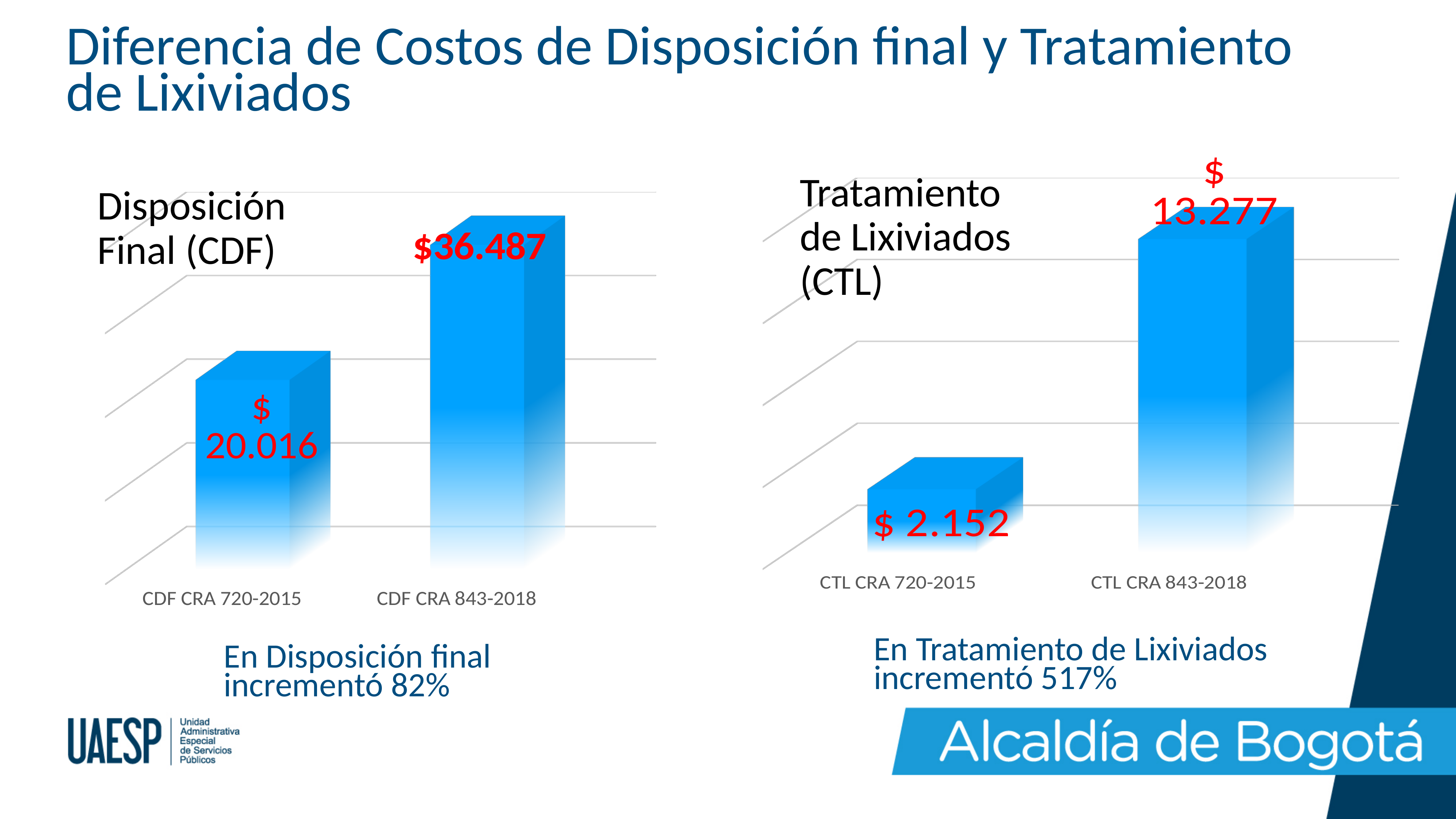
In the Disposición Final (CDF) chart, what is the value for CDF CRA 843-2018? $36.487 In the Tratamiento de Lixiviados (CTL) chart, which category has the lowest value? CTL CRA 720-2015 In the Disposición Final (CDF) chart, what is the difference between CDF CRA 843-2018 and CDF CRA 720-2015? $ 16.471 In the Tratamiento de Lixiviados (CTL) chart, which is larger: CTL CRA 720-2015 or CTL CRA 843-2018? CTL CRA 843-2018 In the Tratamiento de Lixiviados (CTL) chart, what is the difference between CTL CRA 843-2018 and CTL CRA 720-2015? $ 11.125 In the Tratamiento de Lixiviados (CTL) chart, what is the value for CTL CRA 843-2018? $ 13.277 In the Disposición Final (CDF) chart, which category has the highest value? CDF CRA 843-2018 In the Disposición Final (CDF) chart, what is the value for CDF CRA 720-2015? $ 20.016 What kind of chart is the Tratamiento de Lixiviados (CTL) chart? Bar chart In the Tratamiento de Lixiviados (CTL) chart, what is the value for CTL CRA 720-2015? $ 2.152 How many categories does the Disposición Final (CDF) chart show? 2 In the Disposición Final (CDF) chart, do the values rise or fall from CDF CRA 720-2015 to CDF CRA 843-2018? Rise